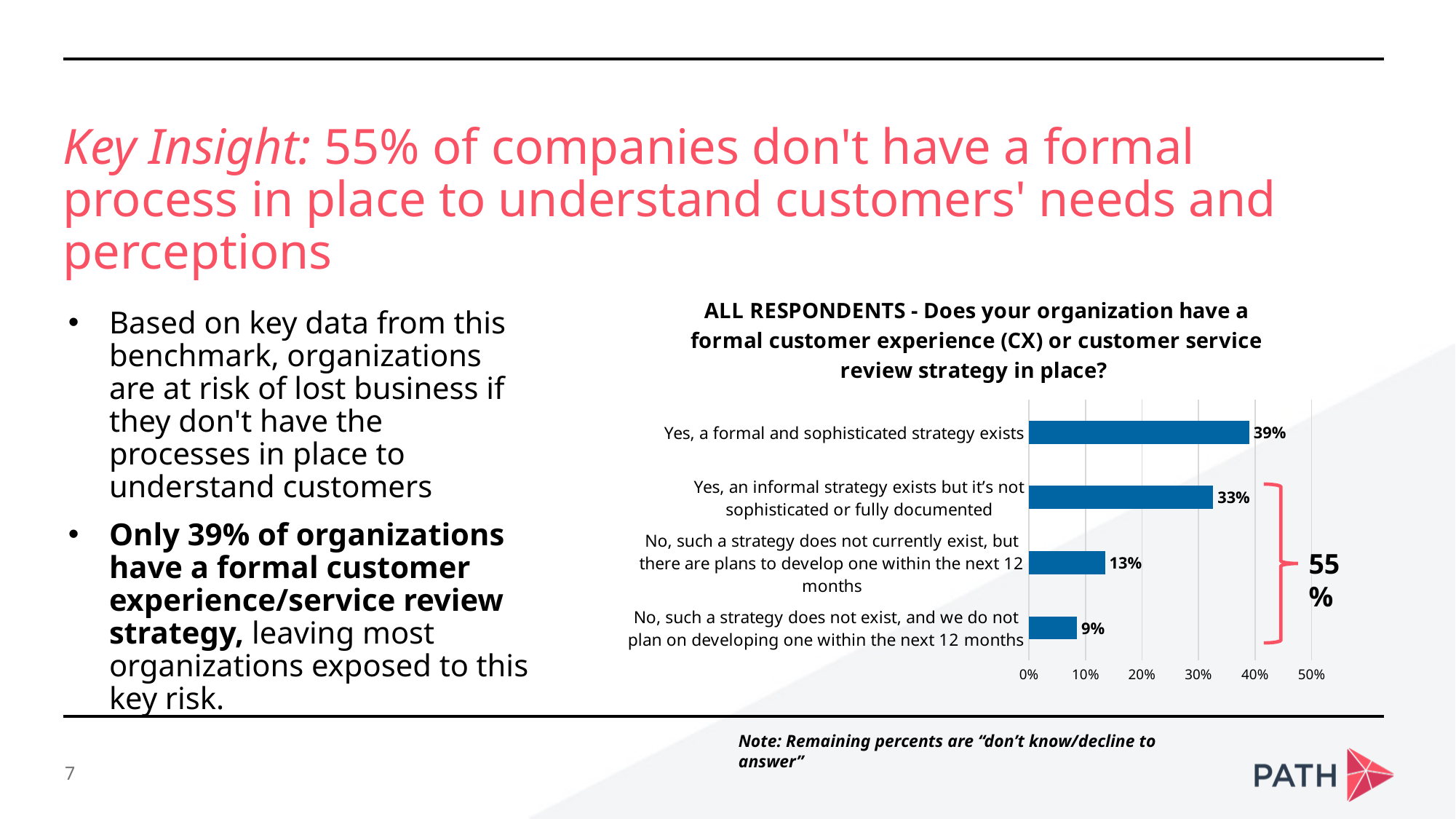
What is the difference in percentage points between 'Yes, a formal and sophisticated strategy exists' and 'Yes, an informal strategy exists but it's not sophisticated or fully documented'? 6% How many response categories are shown in the chart? 4 Is the value for 'Yes, an informal strategy exists but it's not sophisticated or fully documented' greater or less than 30%? greater What combined percentage does the bracket on the right of the chart indicate for the bottom three categories? 55% What percentage of respondents said an informal strategy exists but it's not sophisticated or fully documented? 33% Which response category has the lowest percentage? No, such a strategy does not exist, and we do not plan on developing one within the next 12 months Which is larger: the percentage for 'No, such a strategy does not currently exist, but there are plans to develop one within the next 12 months' or for 'No, such a strategy does not exist, and we do not plan on developing one within the next 12 months'? No, such a strategy does not currently exist, but there are plans to develop one within the next 12 months What percentage of respondents said no such strategy exists and they do not plan on developing one within the next 12 months? 9% What type of chart is shown on the slide? Bar chart Which response category has the highest percentage? Yes, a formal and sophisticated strategy exists What percentage of respondents said no such strategy currently exists but there are plans to develop one within the next 12 months? 13% What percentage of respondents said a formal and sophisticated strategy exists? 39%